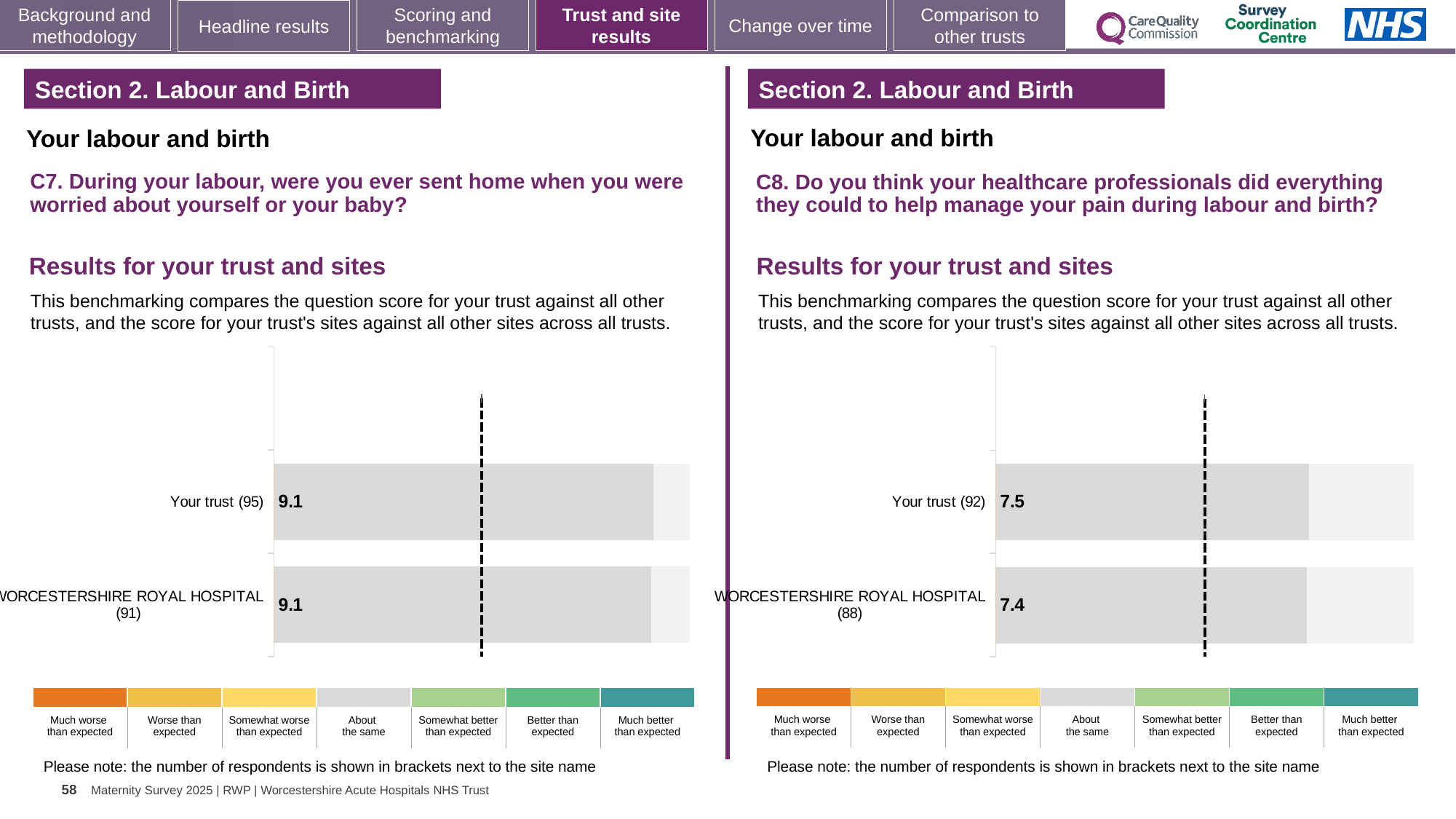
In the C8 chart on the right, how many respondents are shown in brackets for Worcestershire Royal Hospital? 88 In the C8 chart on the right, what is the score for Worcestershire Royal Hospital? 7.4 How many bars are plotted in the C7 chart on the left? 2 In the C7 chart on the left, how many respondents are shown in brackets for Your trust? 95 In the C7 chart on the left, what is the difference between the score for Your trust and the score for Worcestershire Royal Hospital? 0 In the C8 chart on the right, which has the higher score, Your trust or Worcestershire Royal Hospital? Your trust What kind of chart is used for the C8 results on the right? Bar chart In the C8 chart on the right, what is the difference between the score for Your trust and the score for Worcestershire Royal Hospital? 0.1 In the C7 chart on the left, what is the score for Your trust? 9.1 In the C7 chart on the left, what is the score for Worcestershire Royal Hospital? 9.1 In the C8 chart on the right, what is the score for Your trust? 7.5